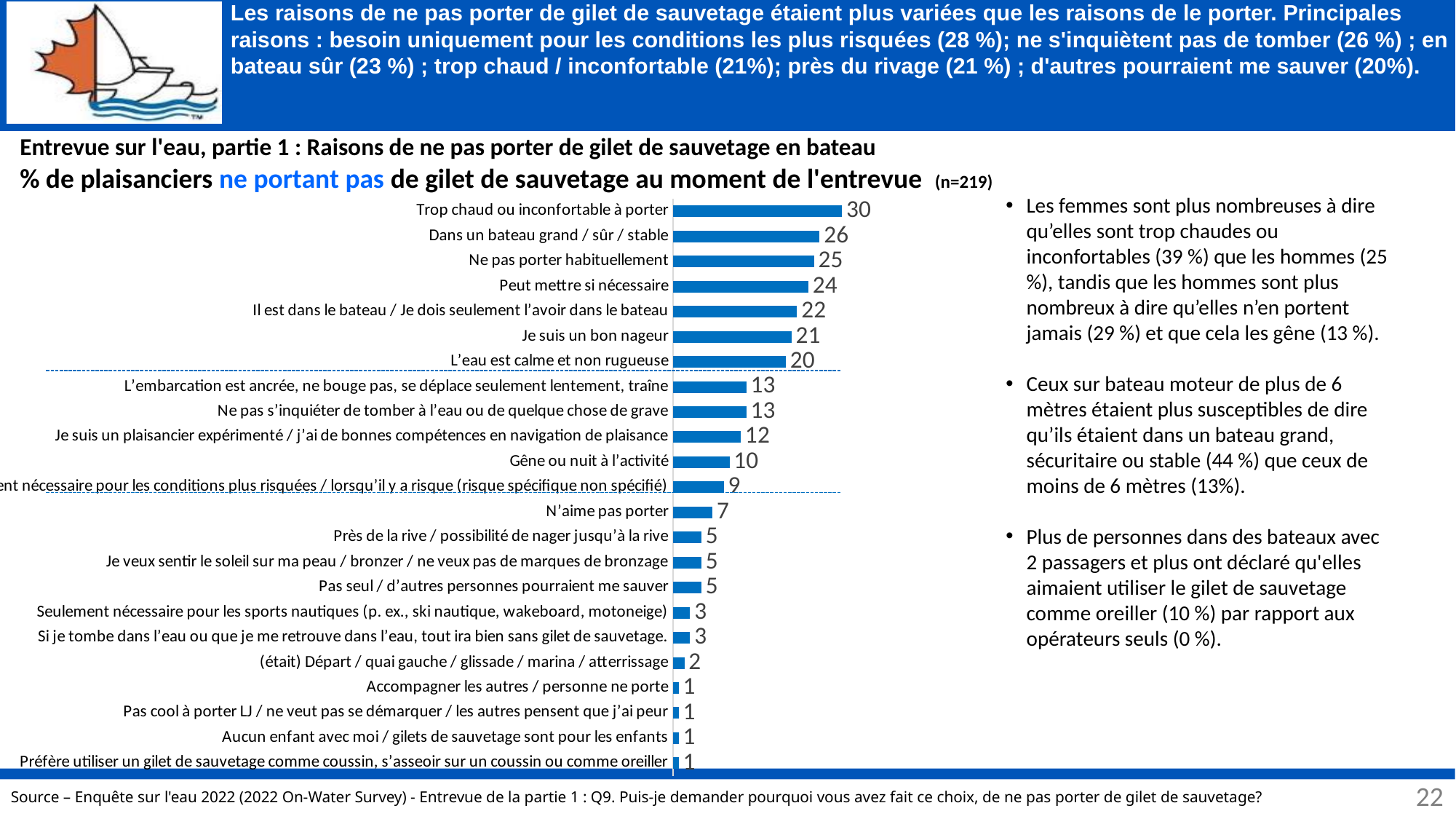
Which category has the highest value? Trop chaud ou inconfortable à porter What is the sample size (n) shown in the chart subtitle? n=219 How many categories are plotted in the chart? 23 What is the value for "N'aime pas porter"? 7 What is the value for "Trop chaud ou inconfortable à porter"? 30 What is the difference between the values for "Dans un bateau grand / sûr / stable" and "Ne pas porter habituellement"? 1 What type of chart is shown on the slide? bar chart What is the value for "Gêne ou nuit à l'activité"? 10 What is the value for "Pas seul / d'autres personnes pourraient me sauver"? 5 Which is larger: the value for "Peut mettre si nécessaire" or the value for "Je suis un plaisancier expérimenté / j'ai de bonnes compétences en navigation de plaisance"? Peut mettre si nécessaire What is the value for "Je suis un bon nageur"? 21 What is the difference between the values for "Trop chaud ou inconfortable à porter" and "L'eau est calme et non rugueuse"? 10